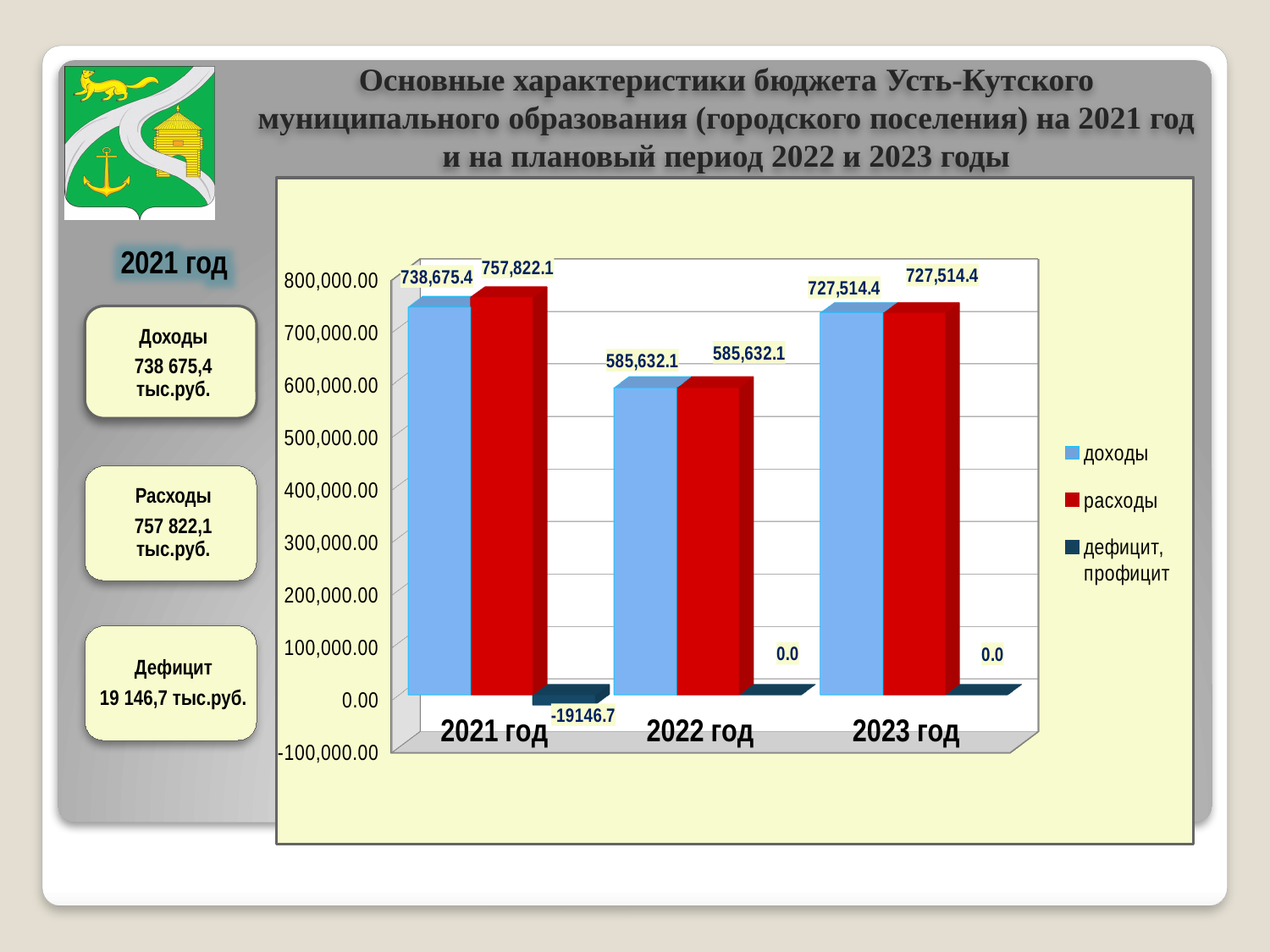
What is the value of дефицит, профицит for 2023 год? 0.0 What is the value of доходы for 2021 год? 738,675.4 How many years are shown on the x axis? 3 What is the value of расходы for 2021 год? 757,822.1 What kind of chart is shown on the slide? Bar chart What is the value of дефицит, профицит for 2021 год? -19146.7 What is the difference between расходы and доходы for 2021 год? 19,146.7 How many series does the legend list? 3 What is the value of доходы for 2023 год? 727,514.4 Which year has the highest value of расходы? 2021 год Which year has the lowest value of доходы? 2022 год What is the value of расходы for 2022 год? 585,632.1